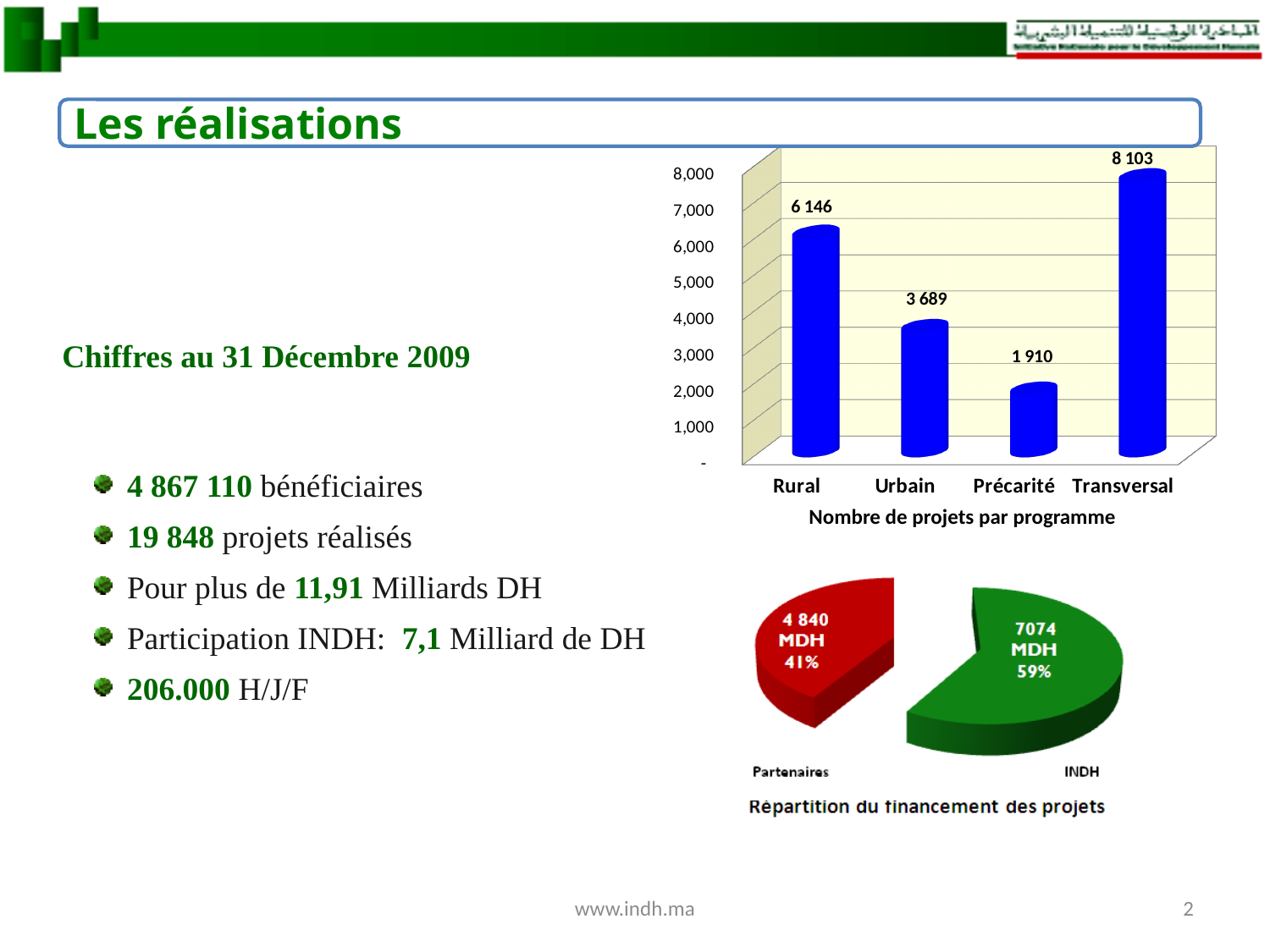
In the 'Nombre de projets par programme' chart, what is the value for Rural? 6 146 In the 'Nombre de projets par programme' chart, which is larger, Rural or Urbain? Rural In the 'Répartition du financement des projets' chart, what is the amount for Partenaires? 4 840 MDH In the 'Répartition du financement des projets' chart, what share of financing comes from INDH? 59% In the 'Nombre de projets par programme' chart, what is the value for Précarité? 1 910 What kind of chart is 'Nombre de projets par programme'? Bar chart In the 'Nombre de projets par programme' chart, which programme has the lowest number of projects? Précarité What kind of chart is 'Répartition du financement des projets'? Pie chart In the 'Nombre de projets par programme' chart, which programme has the highest number of projects? Transversal In the 'Nombre de projets par programme' chart, what is the difference between the values for Transversal and Urbain? 4 414 In the 'Nombre de projets par programme' chart, how many programmes are shown? 4 In the 'Répartition du financement des projets' chart, what colour is the INDH slice? Green